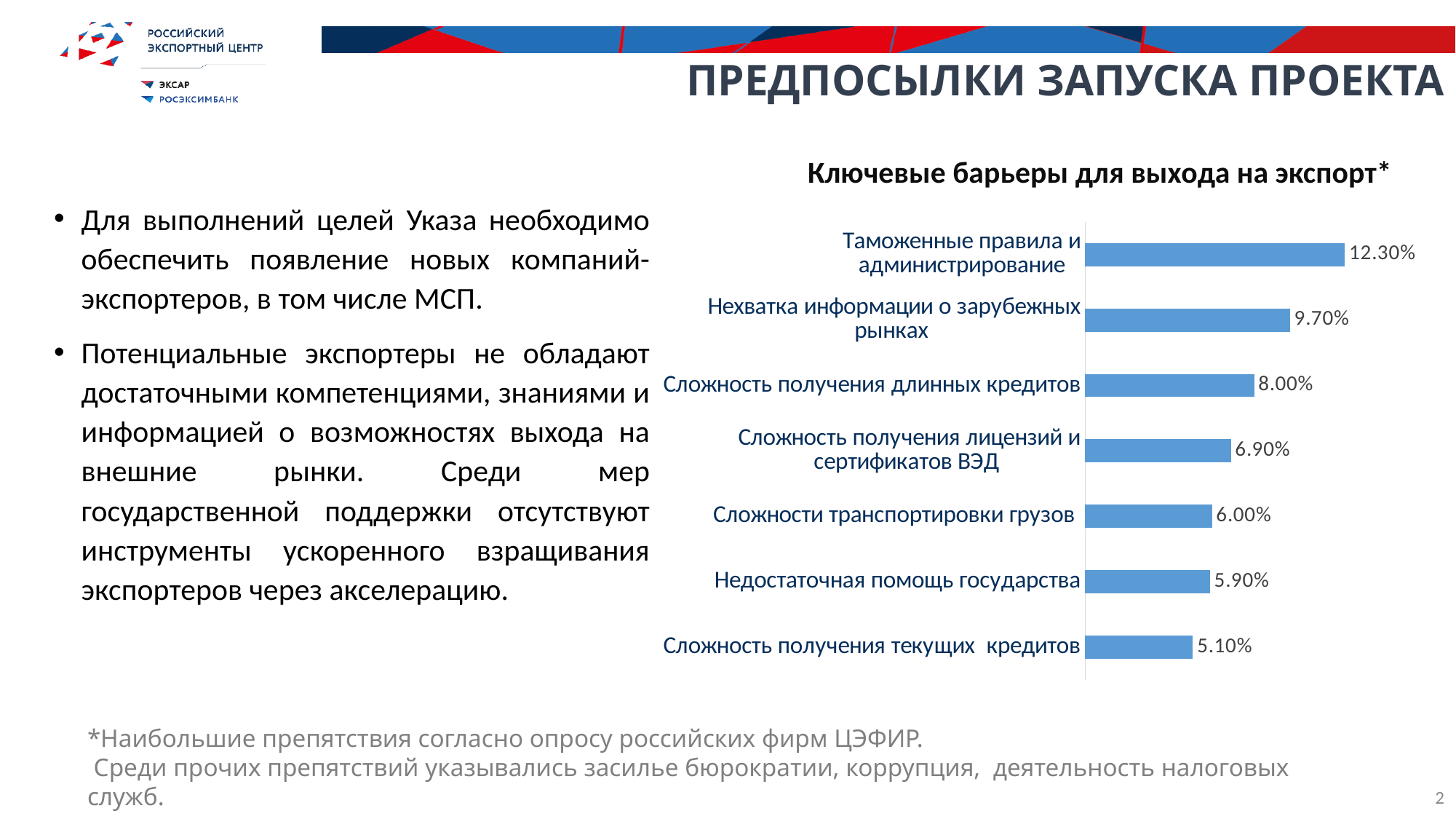
What is the value for «Таможенные правила и администрирование»? 12.30% What is the value for «Нехватка информации о зарубежных рынках»? 9.70% What is the difference between «Таможенные правила и администрирование» and «Нехватка информации о зарубежных рынках»? 2.60% Which barrier has the highest value? Таможенные правила и администрирование Which is larger: «Сложность получения лицензий и сертификатов ВЭД» or «Недостаточная помощь государства»? Сложность получения лицензий и сертификатов ВЭД Which barrier has the lowest value? Сложность получения текущих кредитов What is the title of the chart? Ключевые барьеры для выхода на экспорт* What is the value for «Сложности транспортировки грузов»? 6.00% What kind of chart is shown on the slide? Bar chart How many barriers are shown in the chart? 7 What is the value for «Сложность получения текущих кредитов»? 5.10% What is the value for «Сложность получения длинных кредитов»? 8.00%